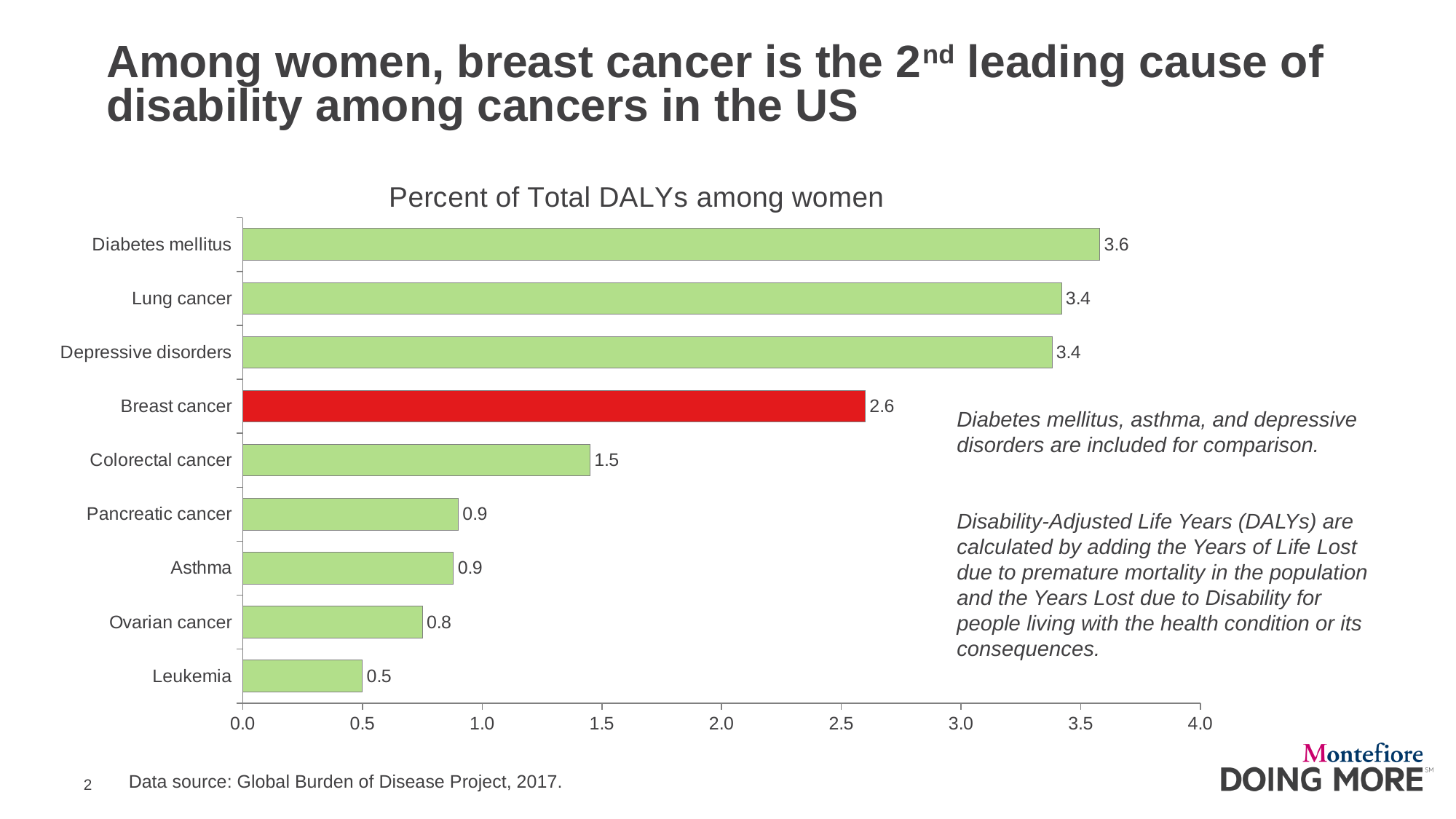
Which is larger, the value for Lung cancer or the value for Breast cancer? Lung cancer Which category has the lowest value? Leukemia What is the title of the chart? Percent of Total DALYs among women What is the difference between the values for Breast cancer and Colorectal cancer? 1.1 What is the value for Breast cancer? 2.6 Which category has the highest value? Diabetes mellitus Is the value for Ovarian cancer greater or less than 1.0? less How many categories are shown in the chart? 9 What kind of chart is shown on the slide? bar chart What is the value for Colorectal cancer? 1.5 What is the value for Leukemia? 0.5 What is the difference between the values for Diabetes mellitus and Breast cancer? 1.0